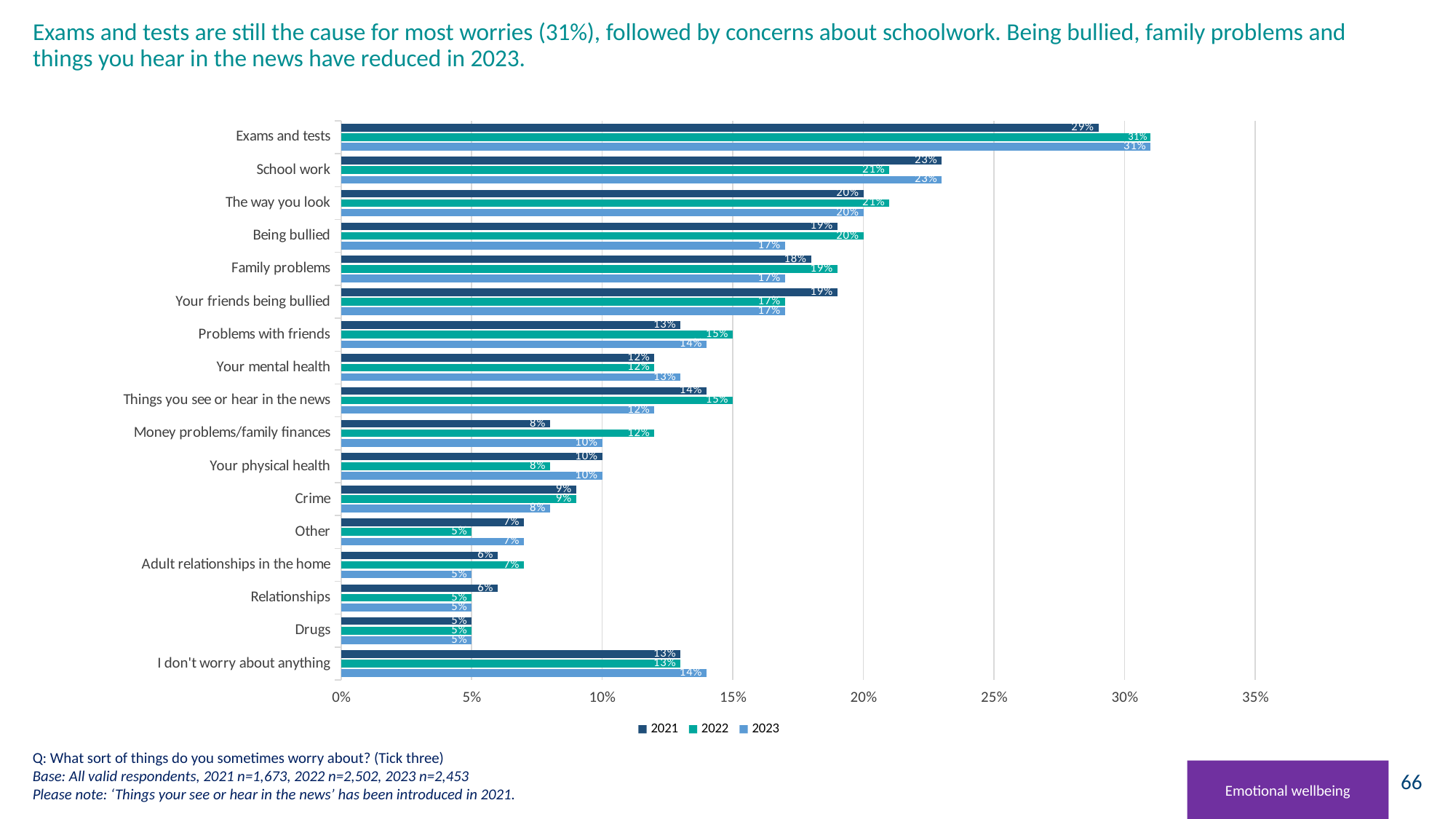
What is the 2021 value for Money problems/family finances? 8% Which series does the legend list first? 2021 What is the 2022 value for Being bullied? 20% Which category has the lowest 2021 value? Drugs How many series does the legend list? 3 What is the difference between the 2022 and 2023 values for Being bullied? 3% How many categories are shown on the chart? 17 What kind of chart is shown on the slide? Bar chart What is the 2023 value for Things you see or hear in the news? 12% Which category has the highest 2023 value? Exams and tests Which is larger for Money problems/family finances: the 2021 value or the 2022 value? 2022 What is the 2023 value for Exams and tests? 31%